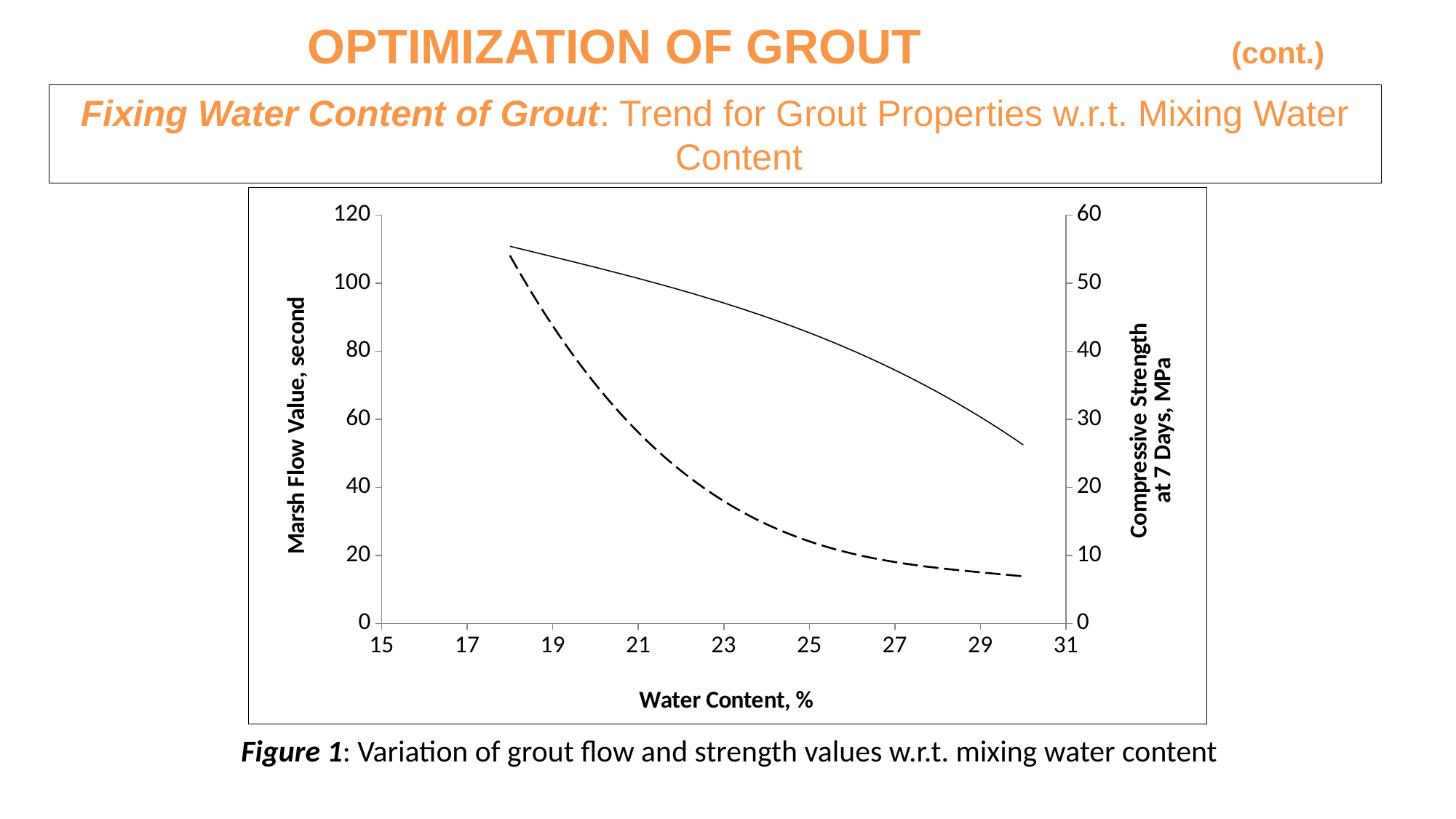
Does the dashed line rise or fall as water content increases along the x axis? fall What is the title of the right-hand y axis of the chart? Compressive Strength at 7 Days, MPa Read on the left axis, is the solid line's value at a water content of 23% greater or less than 80? greater What kind of chart is shown on the slide? line chart Does the solid line rise or fall as water content increases along the x axis? fall At a water content of 25%, which line is higher on the chart, the solid line or the dashed line? solid line Read on the left axis, is the dashed line's value at a water content of 19% greater or less than 80? greater Read on the left axis, is the solid line's value at a water content of 19% greater or less than 100? greater How many lines are plotted on the chart? 2 What is the title of the x axis of the chart? Water Content, %